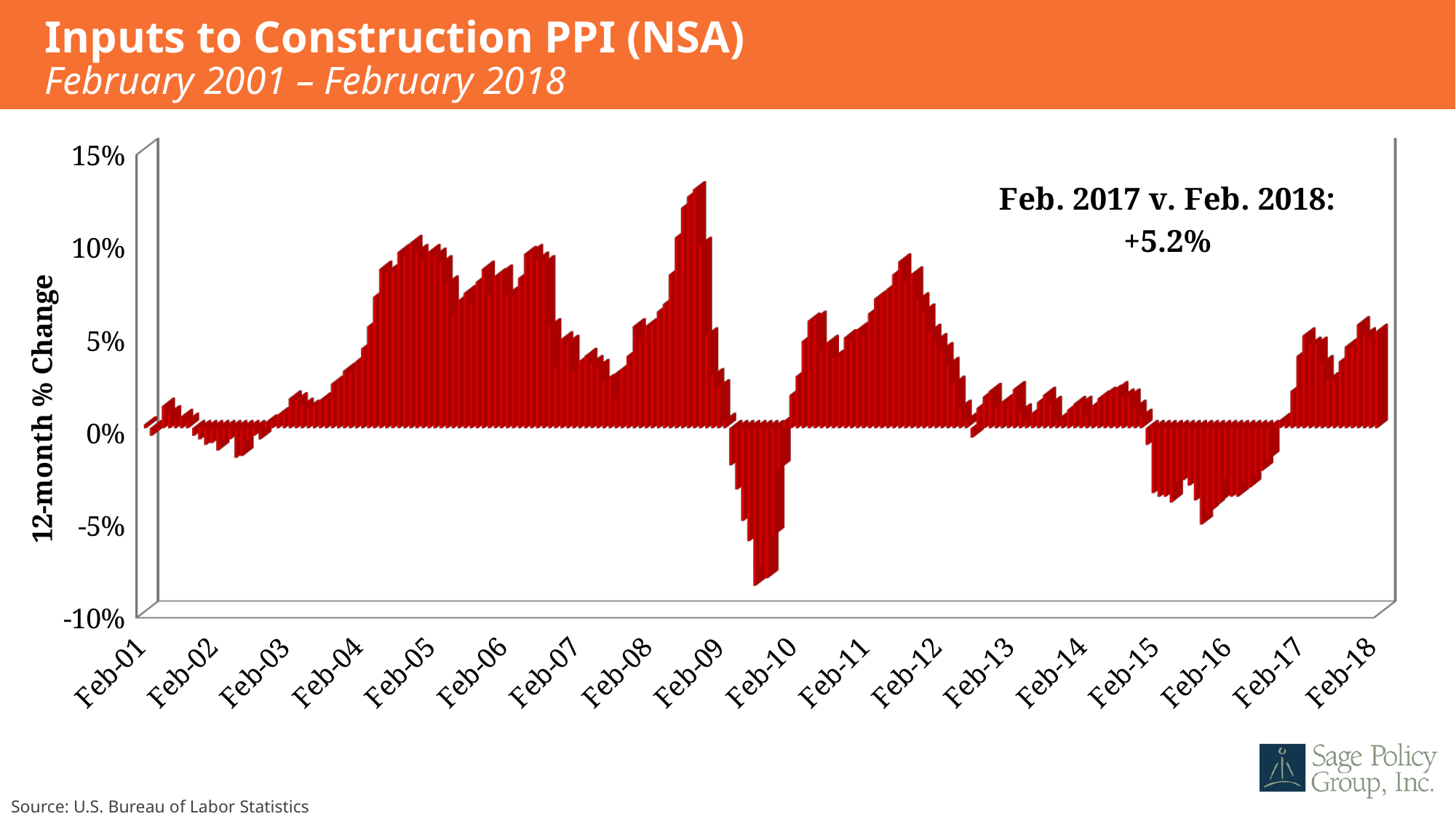
Is the value around Feb-13 greater or less than 5%? less What is the label on the vertical axis? 12-month % Change Is the lowest value on the chart, reached around Feb-10, greater or less than -5%? less What kind of chart is shown on the slide? Bar chart What is the 12-month % change for Feb. 2017 v. Feb. 2018 stated on the chart? +5.2% Is the highest value on the chart, reached around Feb-09, greater or less than 10%? greater Which is larger, the value around Feb-18 or the value around Feb-16? Feb-18 Which is larger, the peak value around Feb-09 or the peak value around Feb-12? Feb-09 What is the title of the chart? Inputs to Construction PPI (NSA)